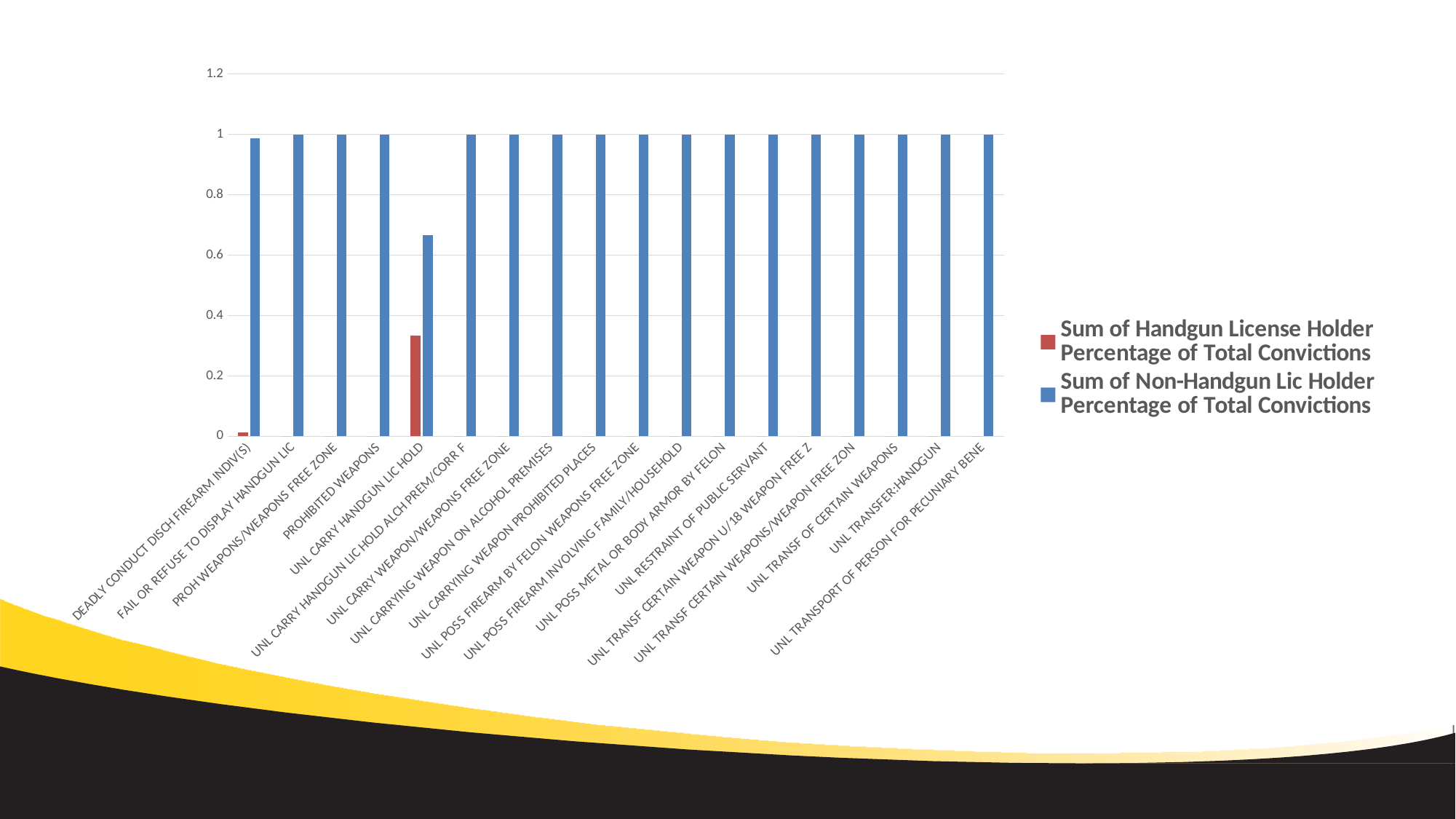
For UNL CARRY HANDGUN LIC HOLD, which series has the larger value: Sum of Handgun License Holder Percentage of Total Convictions or Sum of Non-Handgun Lic Holder Percentage of Total Convictions? Sum of Non-Handgun Lic Holder Percentage of Total Convictions Is the Sum of Handgun License Holder Percentage of Total Convictions for UNL CARRY HANDGUN LIC HOLD greater or less than 0.2? greater How many categories are shown on the x axis? 18 What colour are the bars for Sum of Handgun License Holder Percentage of Total Convictions? red Is the Sum of Non-Handgun Lic Holder Percentage of Total Convictions for PROHIBITED WEAPONS greater or less than 0.8? greater Which is larger: the Sum of Non-Handgun Lic Holder Percentage of Total Convictions for UNL TRANSFER:HANDGUN or for UNL CARRY HANDGUN LIC HOLD? UNL TRANSFER:HANDGUN Is the Sum of Non-Handgun Lic Holder Percentage of Total Convictions for UNL CARRY HANDGUN LIC HOLD greater or less than 0.8? less Which category has the lowest value for Sum of Non-Handgun Lic Holder Percentage of Total Convictions? UNL CARRY HANDGUN LIC HOLD What kind of chart is shown on the slide? bar chart How many series does the legend list? 2 Which category has the highest value for Sum of Handgun License Holder Percentage of Total Convictions? UNL CARRY HANDGUN LIC HOLD What colour are the bars for Sum of Non-Handgun Lic Holder Percentage of Total Convictions? blue